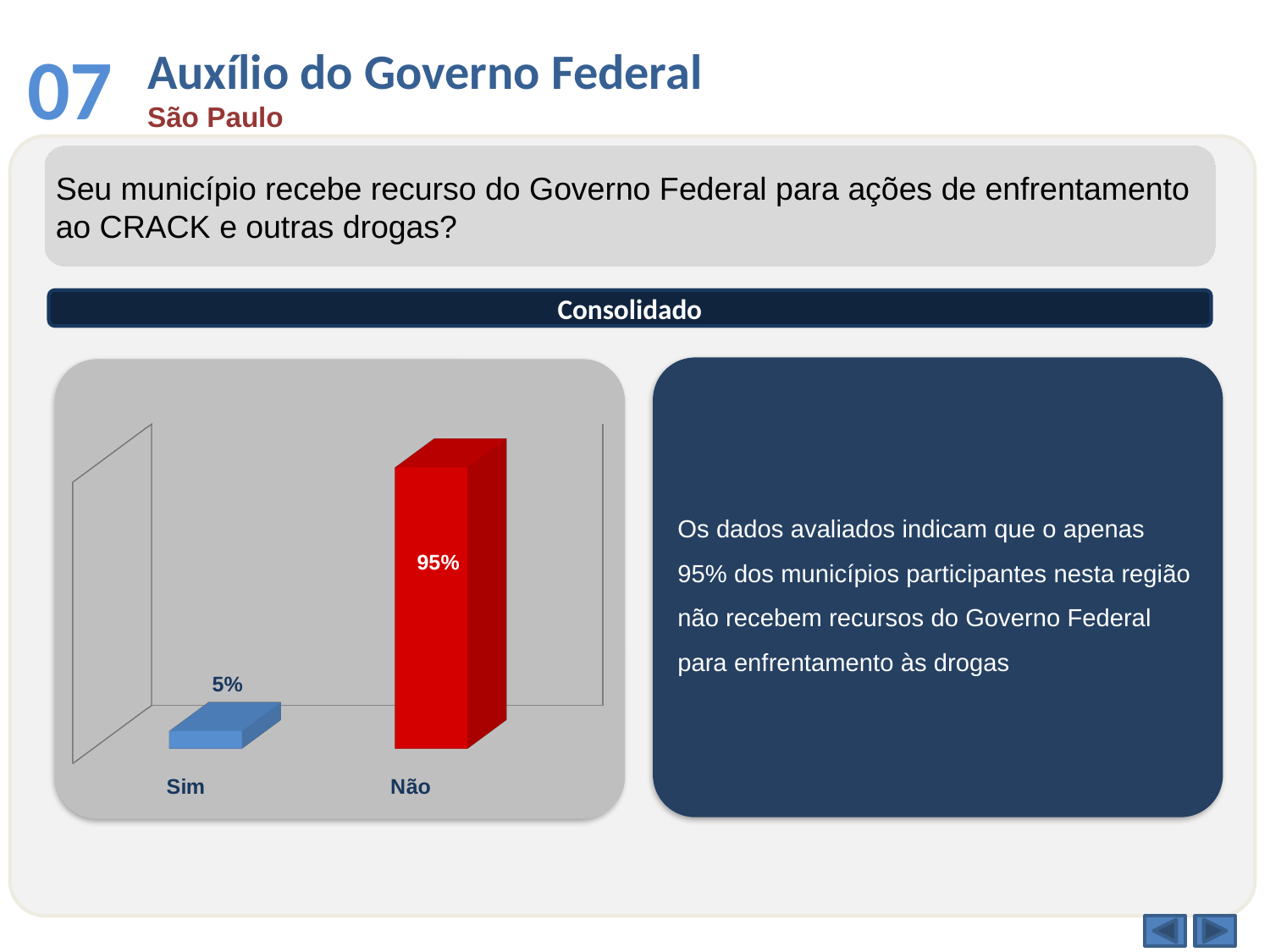
Which category has the highest value? Não What is the value for "Sim"? 5% What is the difference between the values for "Não" and "Sim"? 90% How many categories are shown in the chart? 2 What kind of chart is shown on the slide? Bar chart What colour is the bar for "Não"? Red What colour is the bar for "Sim"? Blue What is the value for "Não"? 95% Which is larger, the value for "Sim" or the value for "Não"? Não Which category has the lowest value? Sim What is the total of the two values shown in the chart? 100%